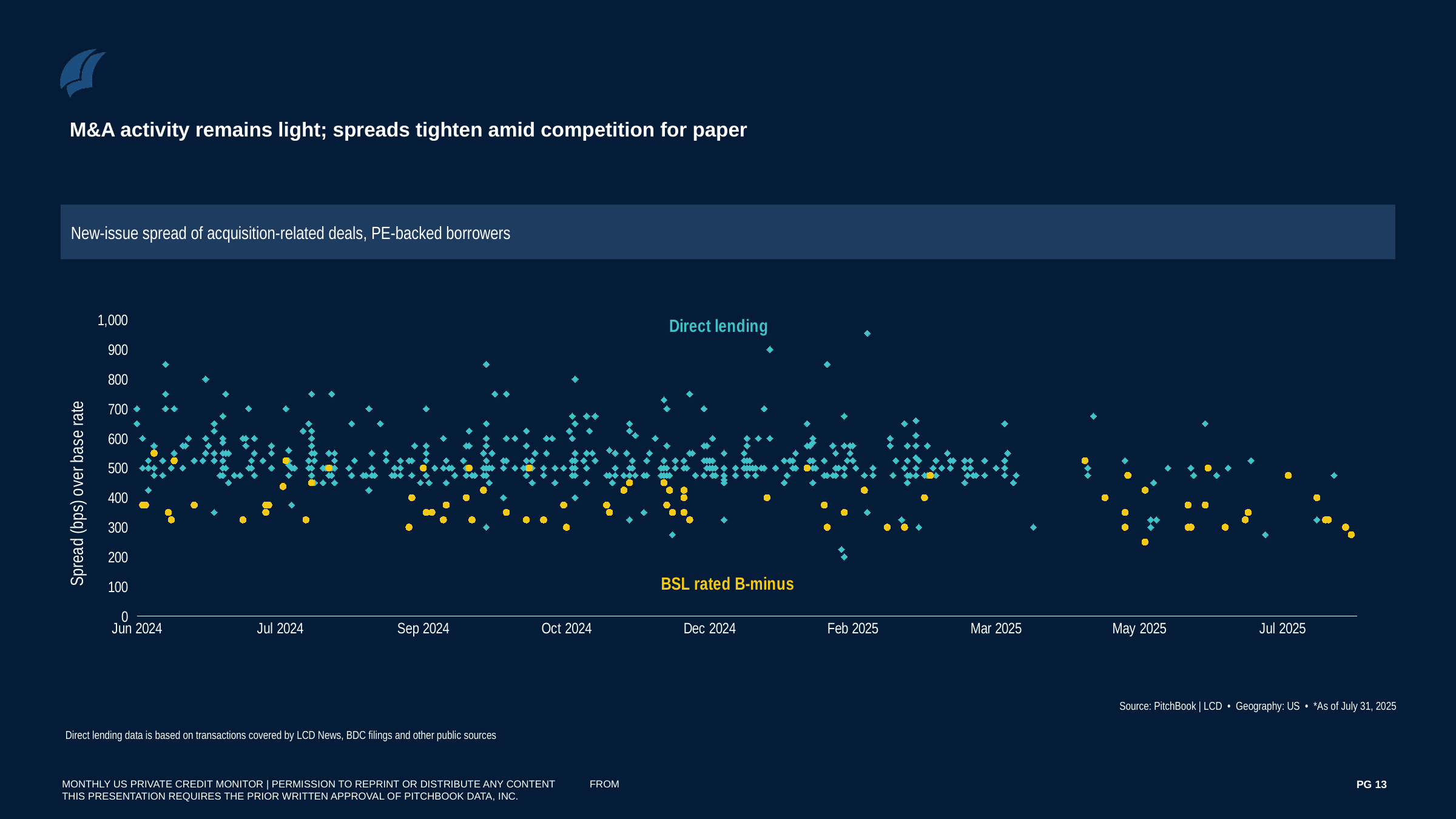
Is the highest BSL rated B-minus point on the chart greater or less than 600? less Is the highest Direct lending point on the chart greater or less than 900? greater How many data series are plotted on the chart? 2 What is the first month label on the x axis of the chart? Jun 2024 Is the lowest Direct lending point on the chart greater or less than 300? less How many month labels are shown on the x axis of the chart? 9 Do the BSL rated B-minus spreads generally rise or fall from Jun 2024 to Jul 2025? fall What are the names of the two series plotted on the chart? Direct lending and BSL rated B-minus What kind of chart is shown on the slide? Scatter chart Which series reaches the highest spread on the chart, Direct lending or BSL rated B-minus? Direct lending What is the title of the chart? New-issue spread of acquisition-related deals, PE-backed borrowers